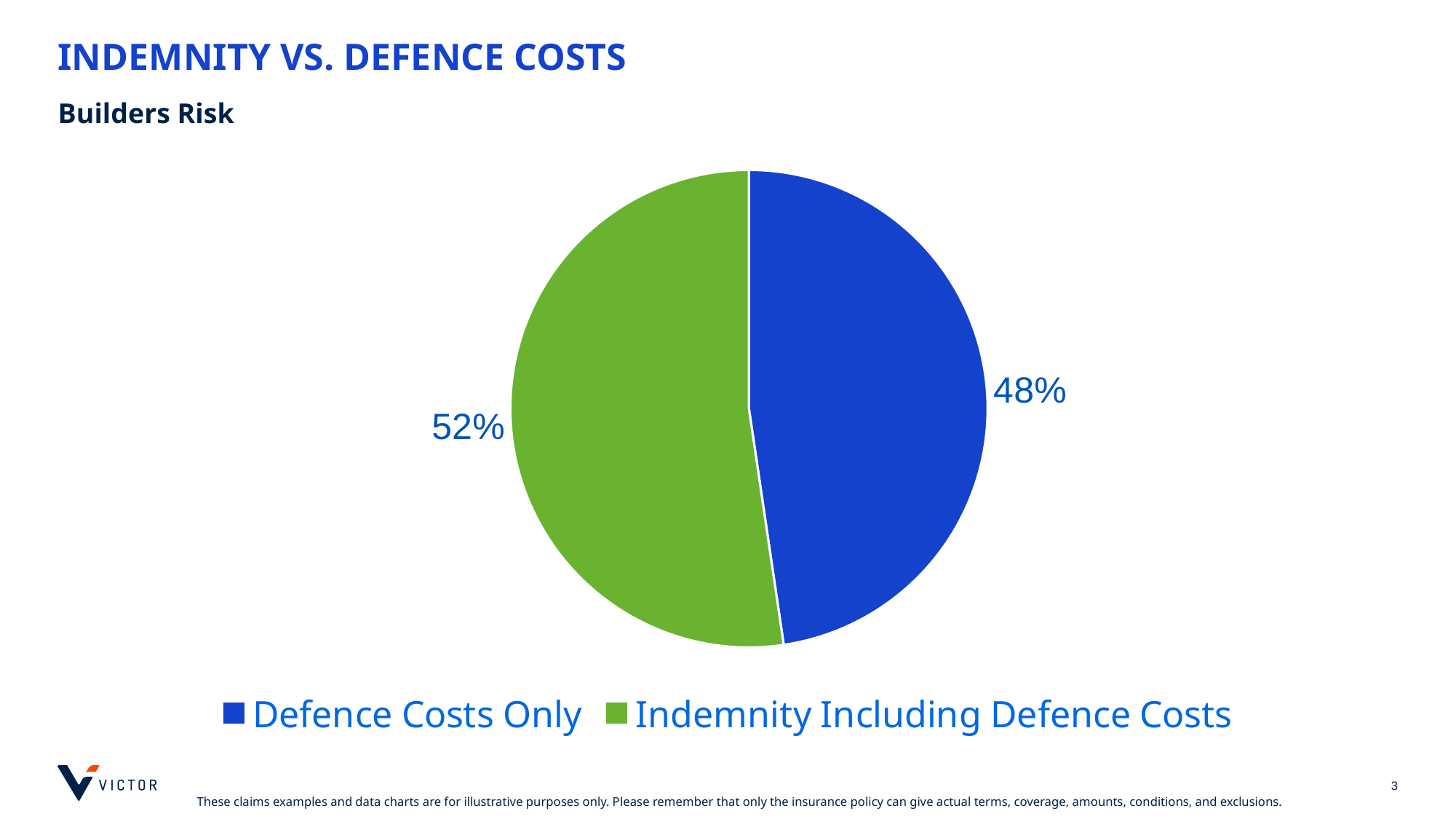
Which is larger, Defence Costs Only or Indemnity Including Defence Costs? Indemnity Including Defence Costs What percentage of the pie is Indemnity Including Defence Costs? 52% How many entries does the legend list? 2 What share of the pie does the Defence Costs Only slice represent? 48% How many slices does the pie chart have? 2 Which slice is the largest? Indemnity Including Defence Costs What colour is the Indemnity Including Defence Costs slice? Green What kind of chart is shown on the slide? Pie chart What is the title of the slide containing the chart? INDEMNITY VS. DEFENCE COSTS Which slice is the smallest? Defence Costs Only What percentage of the pie is Defence Costs Only? 48% What is the difference in percentage points between Indemnity Including Defence Costs and Defence Costs Only? 4